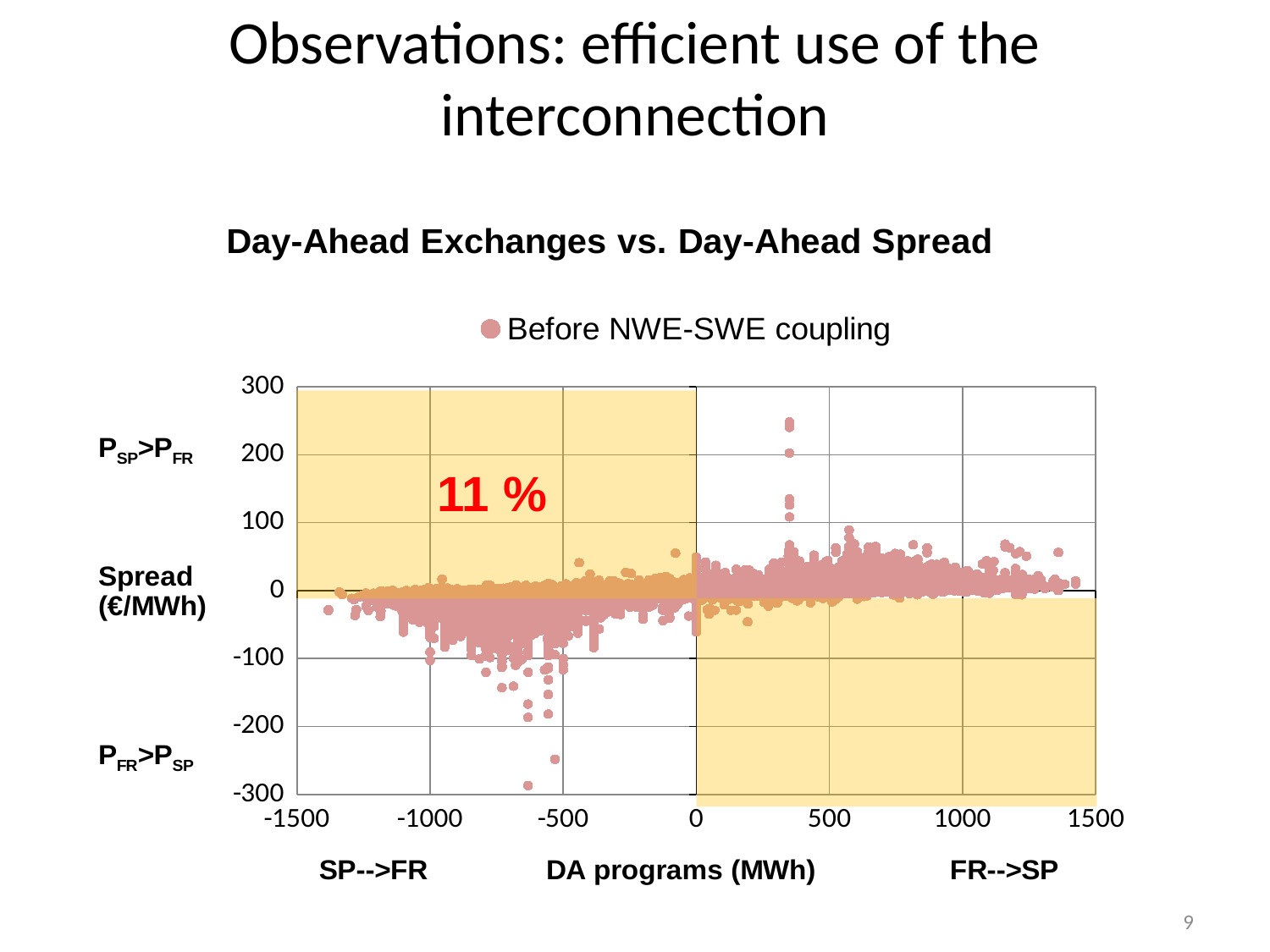
What percentage is annotated in the shaded upper-left region of the chart? 11 % How many series does the chart legend list? 1 Is the DA programs value of the point with the highest spread greater or less than 0? greater Is the highest spread value plotted on the chart greater or less than 200? greater Is the lowest spread value plotted on the chart greater or less than -100? less What is the title of the chart? Day-Ahead Exchanges vs. Day-Ahead Spread What kind of chart is shown on the slide? scatter chart